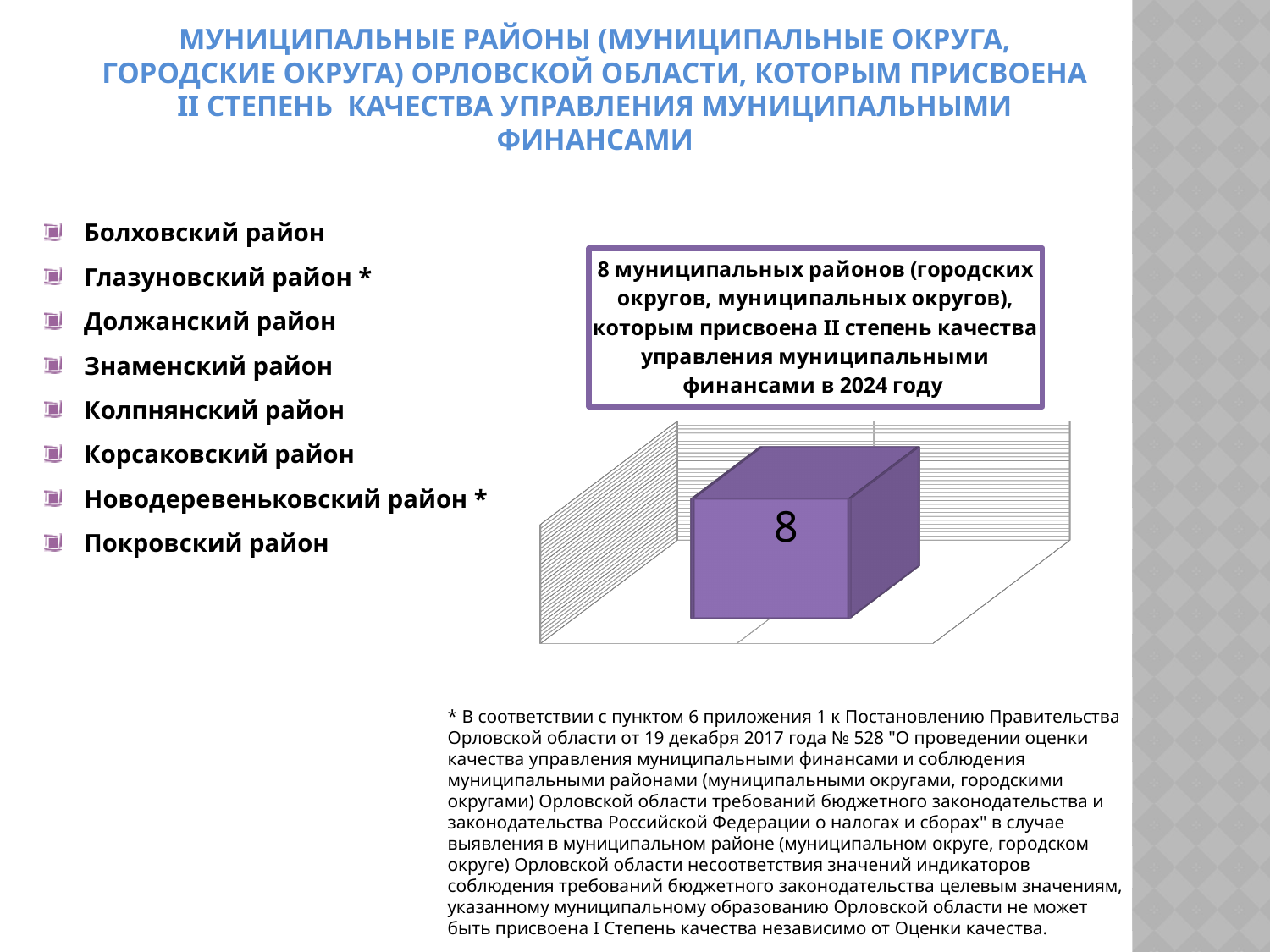
How many bars are plotted in the chart? 1 According to the chart's title box, for which year is the number of municipal districts with II degree of quality of municipal finance management shown? 2024 What value is printed on the single bar in the chart? 8 What kind of chart is shown on the slide? bar chart What colour is the bar in the chart? purple Is the value shown on the bar greater or less than 5? greater